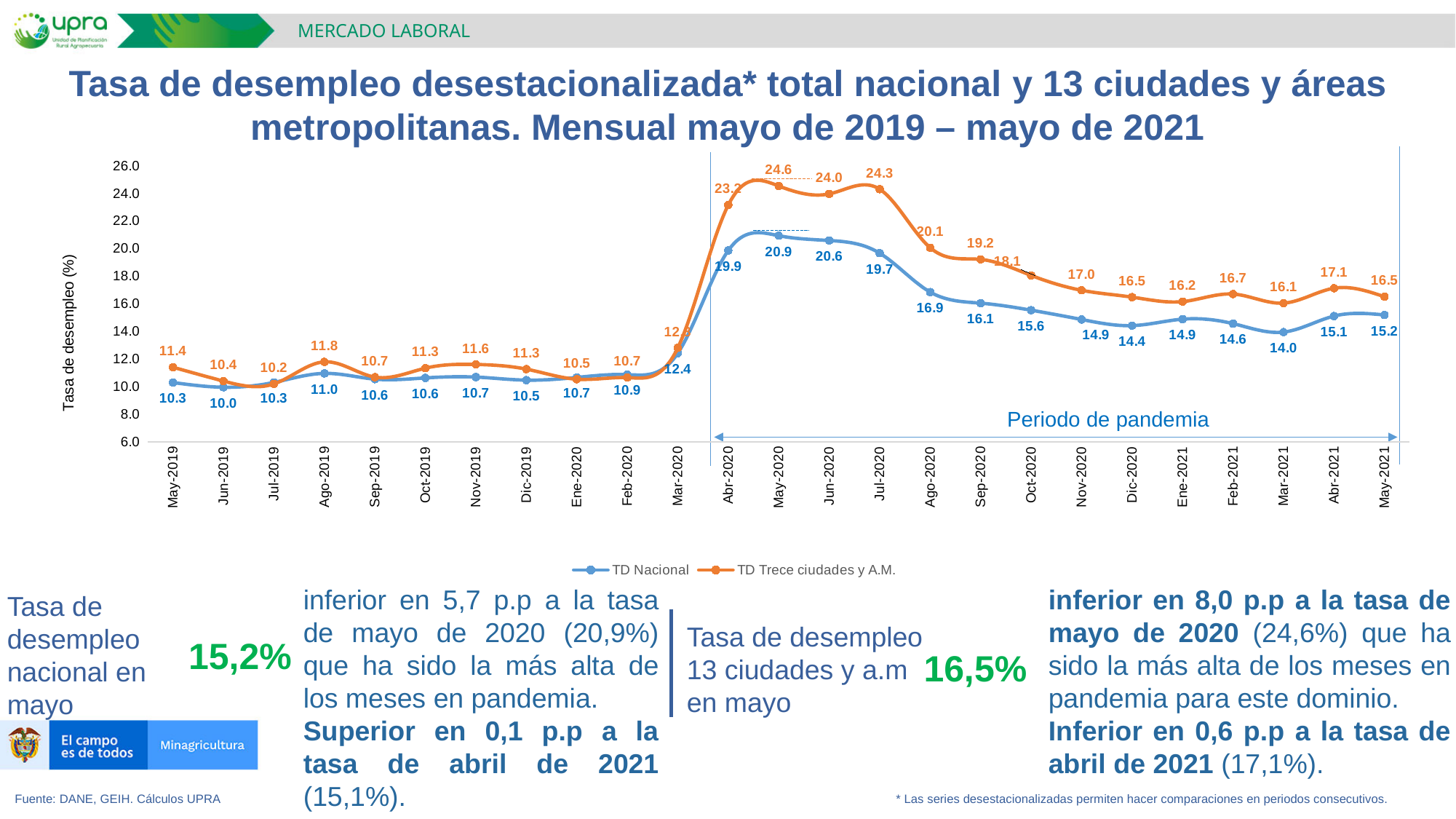
How many months are plotted on the x axis? 25 What is the highest value of TD Trece ciudades y A.M.? 24.6 In which month does TD Nacional have its lowest value? Jun-2019 What is the value of TD Nacional for Mar-2021? 14.0 Does TD Nacional rise or fall from Abr-2020 to Mar-2021? fall How many series does the legend list? 2 Which series has the higher value in Jul-2020, TD Nacional or TD Trece ciudades y A.M.? TD Trece ciudades y A.M. In which month does TD Nacional reach its highest value? May-2020 What is the value of TD Nacional for May-2021? 15.2 What is the difference between TD Trece ciudades y A.M. and TD Nacional in May-2020? 3.7 What type of chart is shown on the slide? line chart What is the value of TD Trece ciudades y A.M. for Abr-2020? 23.2